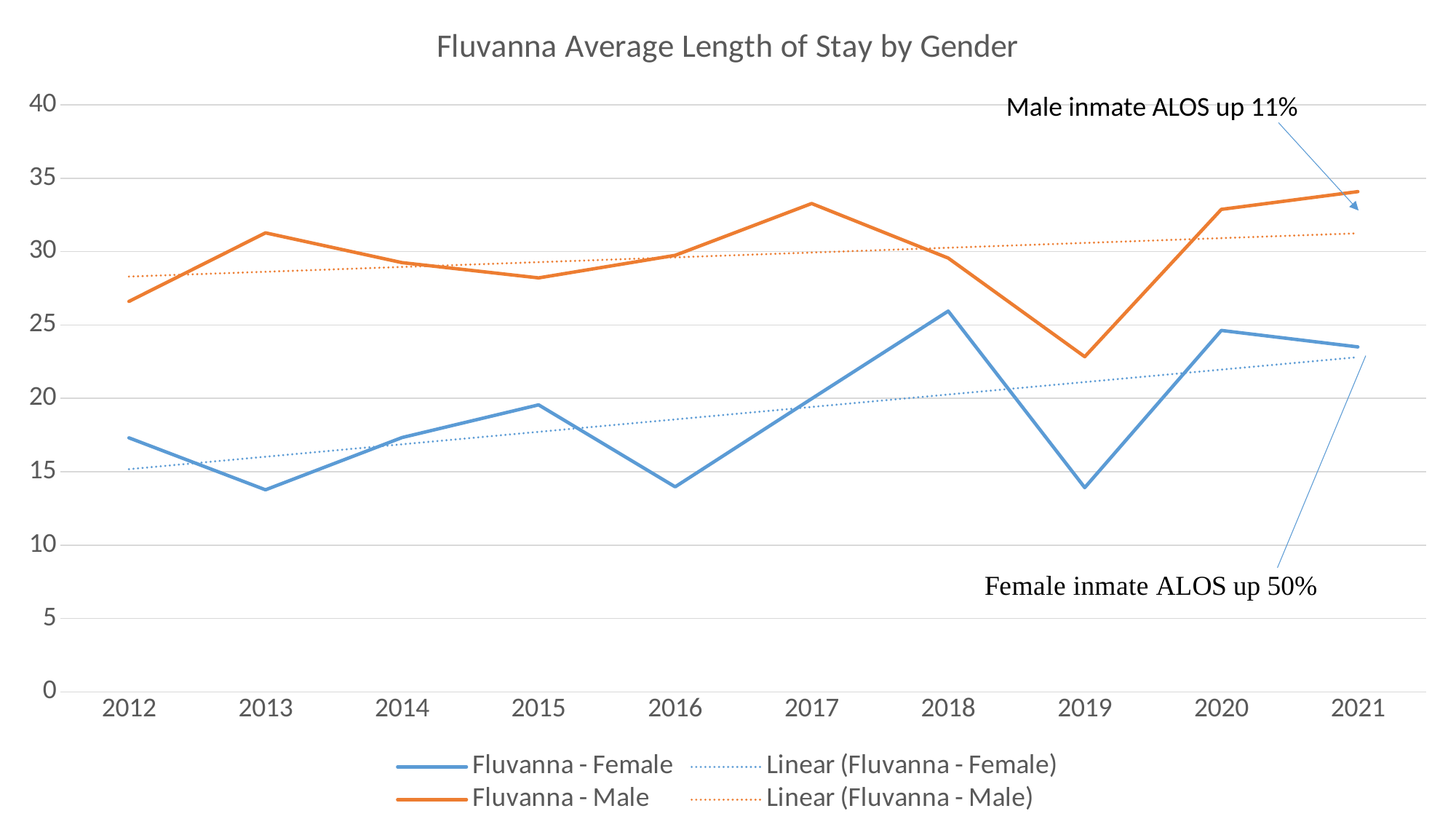
Is the value for Fluvanna - Male in 2019 greater or less than 25? less How many entries does the chart legend list? 4 How many years are plotted along the x axis? 10 According to the annotation on the chart, by what percentage is female inmate ALOS up? 50% Is the value for Fluvanna - Female in 2018 greater or less than 25? greater In which year does the Fluvanna - Male series reach its lowest value? 2019 Which series has the larger value in 2019, Fluvanna - Male or Fluvanna - Female? Fluvanna - Male What type of chart is shown on the slide? Line chart What is the title of the chart? Fluvanna Average Length of Stay by Gender Is the value for Fluvanna - Male in 2017 greater or less than 30? greater In which year does the Fluvanna - Female series reach its highest value? 2018